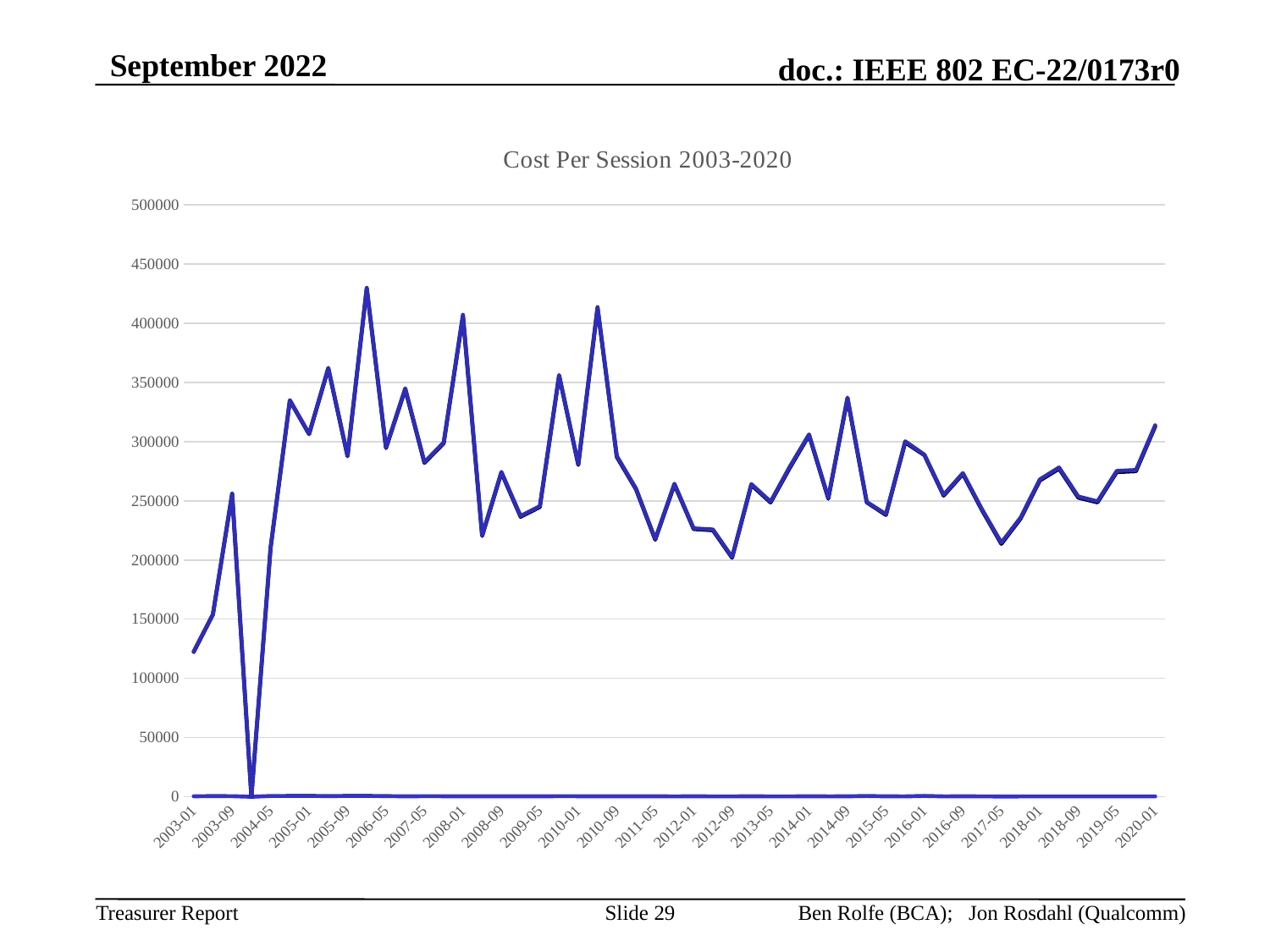
Is the cost per session for 2017-05 greater or less than 250000? less What is the highest value labelled on the vertical axis? 500000 What is the title of the chart? Cost Per Session 2003-2020 Which has the higher cost per session, 2003-01 or 2020-01? 2020-01 What kind of chart is shown on the slide? line chart Is the cost per session for 2020-01 greater or less than 300000? greater Which has the higher cost per session, 2014-09 or 2017-05? 2014-09 Does the cost per session rise or fall from 2017-05 to 2020-01? rise Is the cost per session for 2008-01 greater or less than 350000? greater